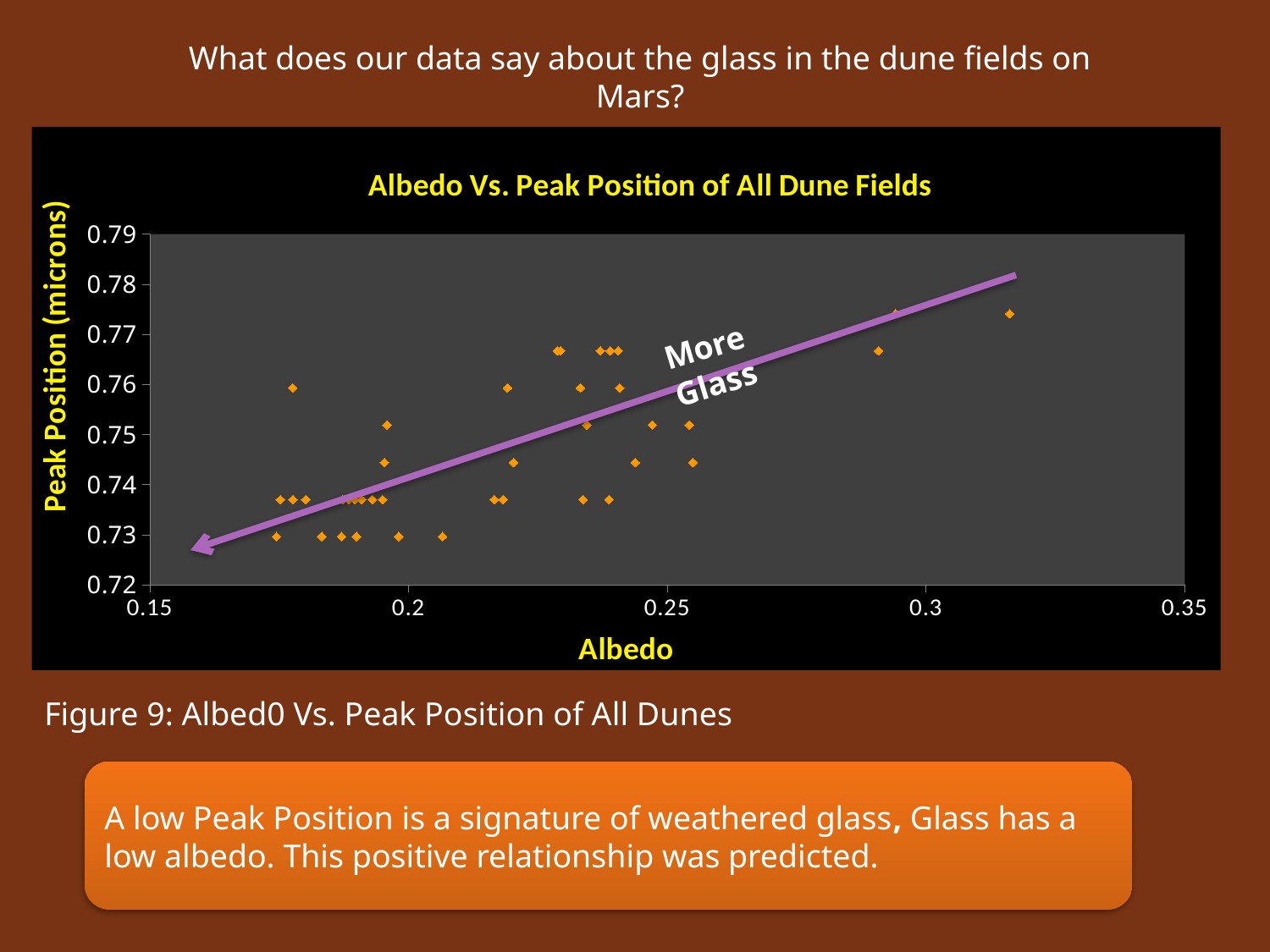
What is the title of the chart? Albedo Vs. Peak Position of All Dune Fields Is the lowest peak position value plotted on the chart greater or less than 0.74? less Is the peak position of the point with the largest albedo greater or less than 0.75? greater What kind of chart is shown on the slide? scatter chart Is the smallest albedo value plotted on the chart greater or less than 0.2? less What is the label of the vertical axis of the chart? Peak Position (microns) Do the peak position values generally rise or fall as albedo increases along the x axis? rise